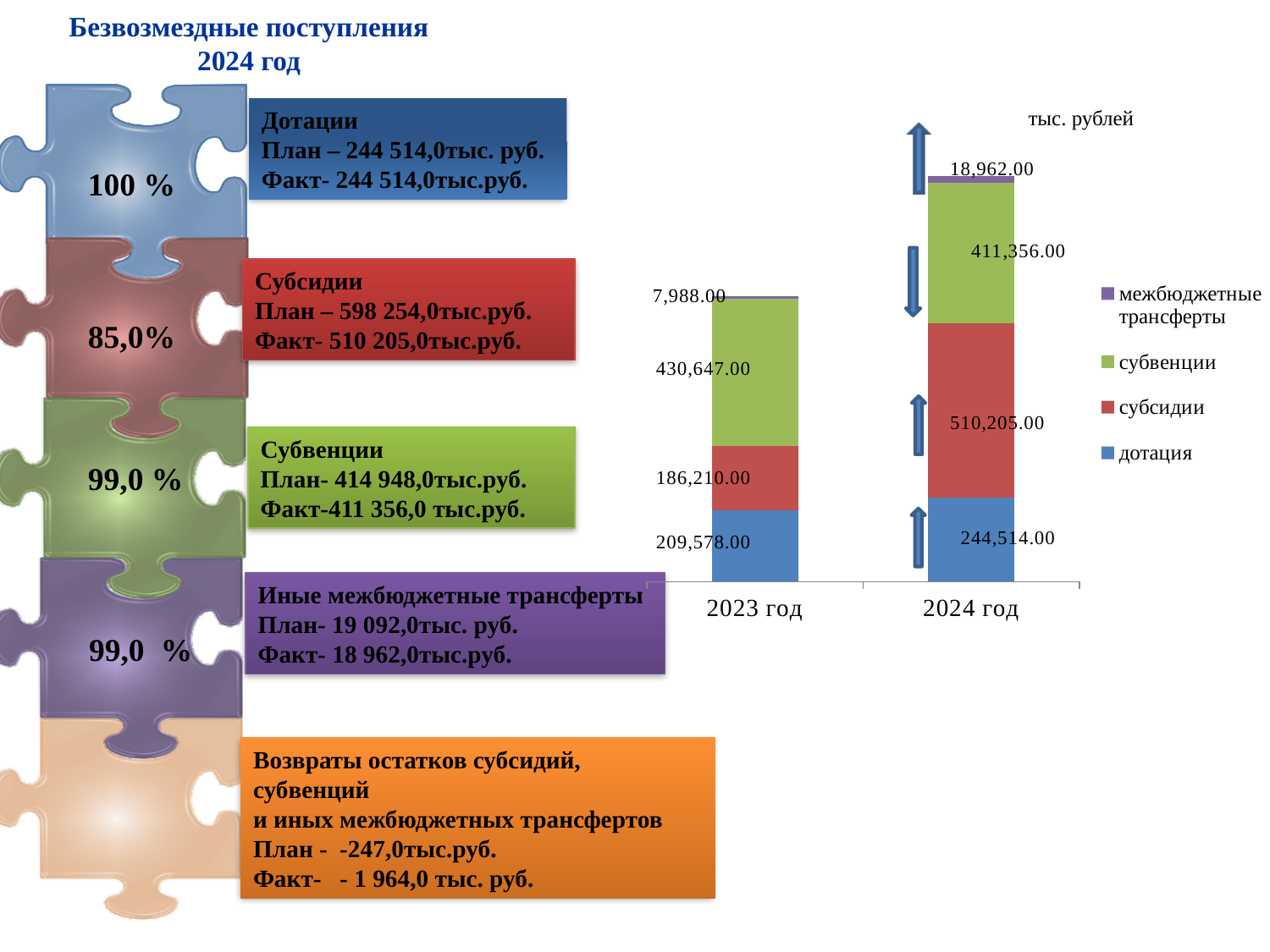
How many categories (years) are shown on the x axis of the chart? 2 What is the value of субсидии for 2023 год? 186,210.00 What is the total of the stacked bar for 2024 год? 1,185,037.00 What is the value of межбюджетные трансферты for 2024 год? 18,962.00 What type of chart is shown on the slide? Stacked bar chart Which series has the smallest value in the 2023 год bar? межбюджетные трансферты Is the value of субвенции larger in 2023 год or in 2024 год? 2023 год How many series does the chart legend list? 4 By how much did субсидии increase from 2023 год to 2024 год? 323,995.00 Which series has the largest value in the 2024 год bar? субсидии What is the value of дотация for 2024 год? 244,514.00 What is the value of субвенции for 2023 год? 430,647.00